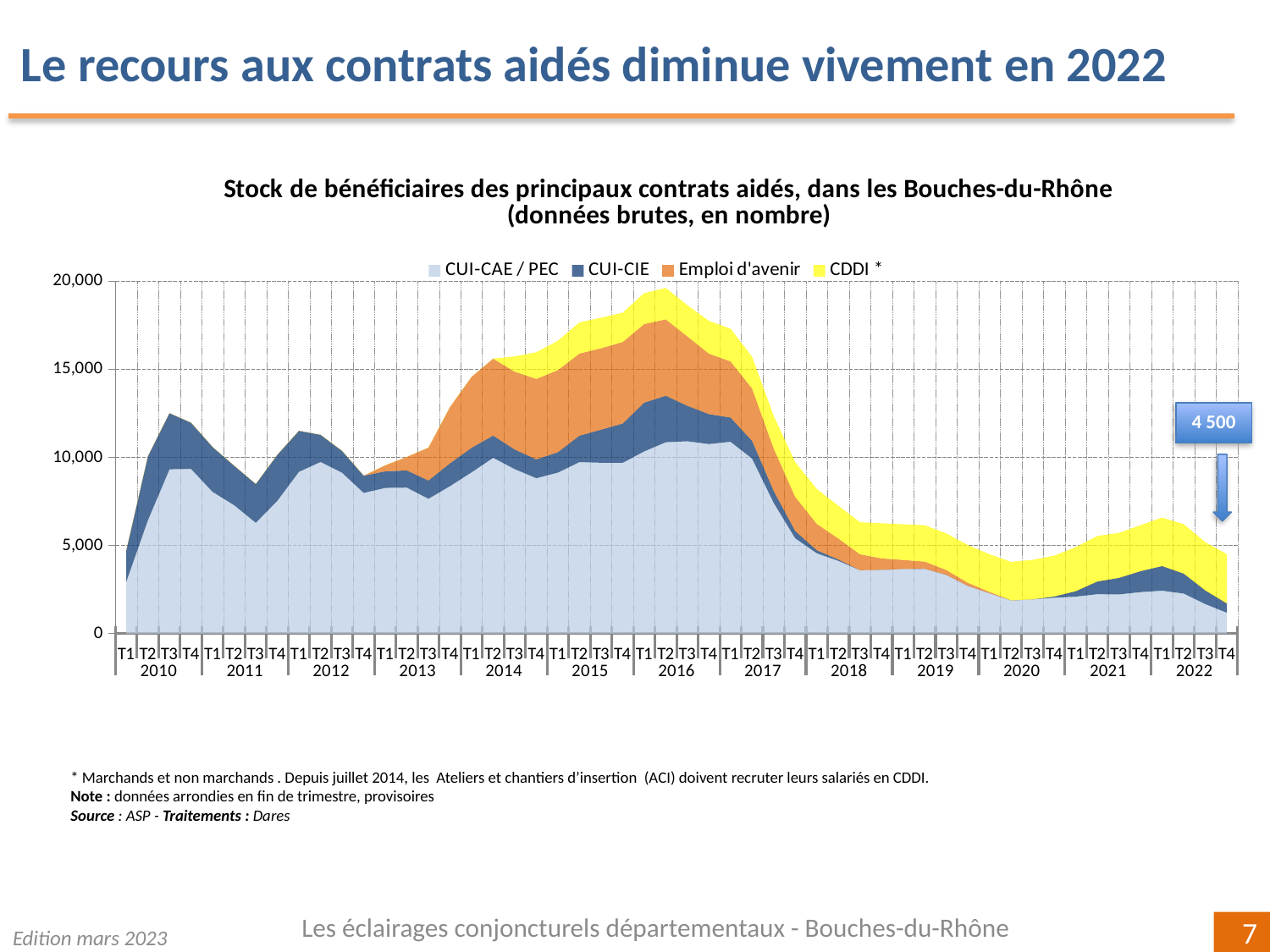
Is the total stock in T2 2016 larger or smaller than in T4 2022? larger Does the total stock rise or fall between 2017 and 2020? fall What is the title of the chart? Stock de bénéficiaires des principaux contrats aidés, dans les Bouches-du-Rhône (données brutes, en nombre) Is the total stock in T2 2016 greater or less than 15,000? greater Is the total stock in T1 2010 greater or less than 10,000? less How many series does the legend list? 4 Is the total stock in T4 2020 greater or less than 5,000? less Which series is shown in yellow? CDDI * How many years are shown on the x axis? 13 What type of chart is shown on the slide? Stacked area chart In which year does the total stock of beneficiaries reach its highest level? 2016 What value does the annotation at the end of the series (T4 2022) show? 4 500